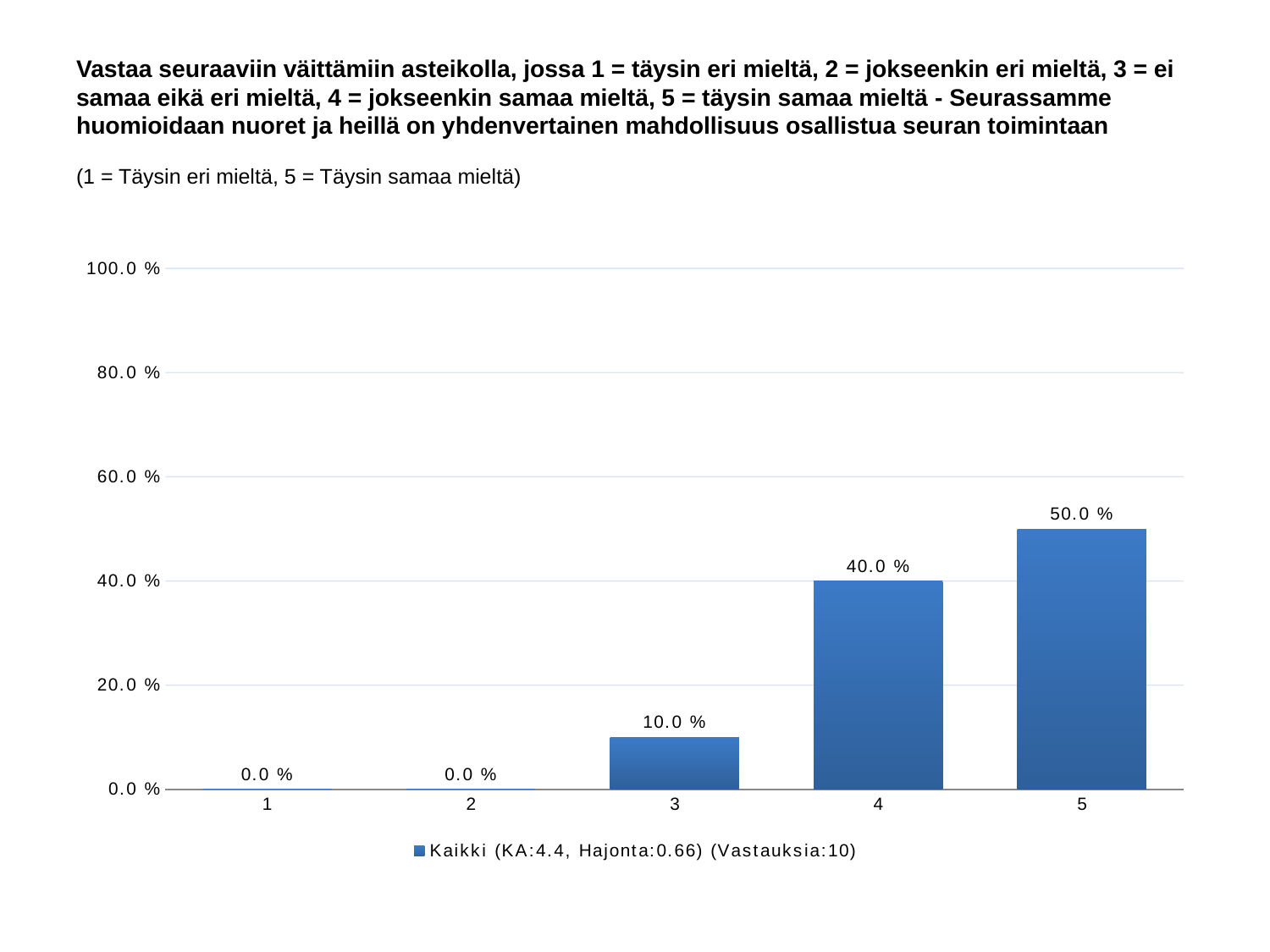
How many responses (Vastauksia) does the legend report? 10 How many categories are shown on the x axis? 5 Which category has the highest value? 5 What is the value for category 3? 10.0 % What is the value for category 4? 40.0 % What is the value for category 1? 0.0 % Which is larger, the value for category 3 or the value for category 4? 4 What is the difference between the values for categories 4 and 3? 30.0 % What kind of chart is shown on the slide? bar chart What is the value for category 5? 50.0 % What is the difference between the values for categories 5 and 4? 10.0 % Is the value for category 5 greater or less than 40.0 %? greater